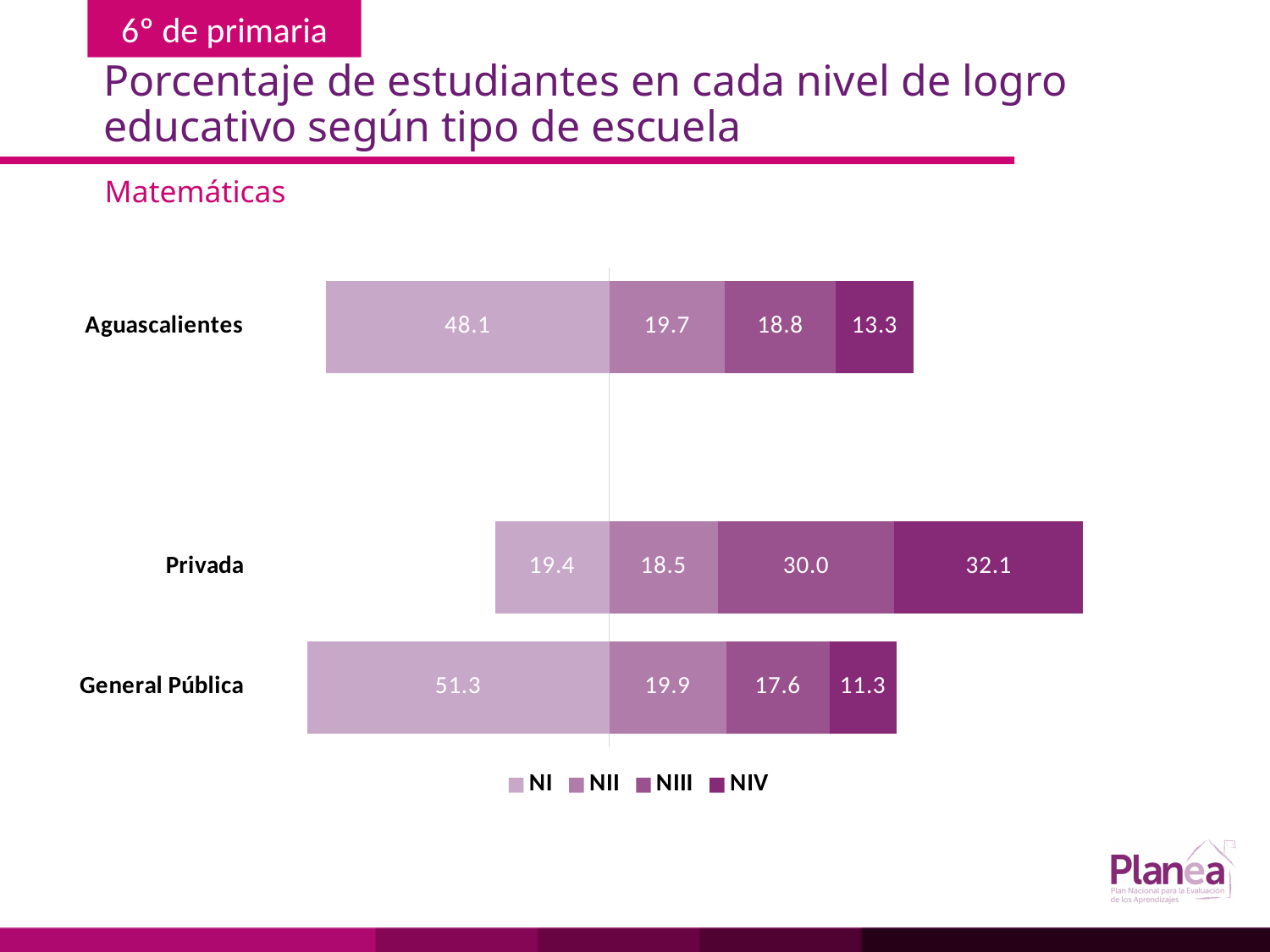
What subject is named above the chart? Matemáticas What type of chart is shown on the slide? Stacked bar chart What is the NIV value for Privada? 32.1 What is the NI value for Aguascalientes? 48.1 What is the NIII value for General Pública? 17.6 What is the difference between the NIV values for Privada and Aguascalientes? 18.8 How many series does the legend list? 4 What is the total of the stacked bar for Privada? 100.0 Which is larger, the NIII value for Privada or the NIII value for Aguascalientes? Privada Which category has the highest NI value? General Pública How many school-type categories are plotted in the chart? 3 Which category has the lowest NIV value? General Pública